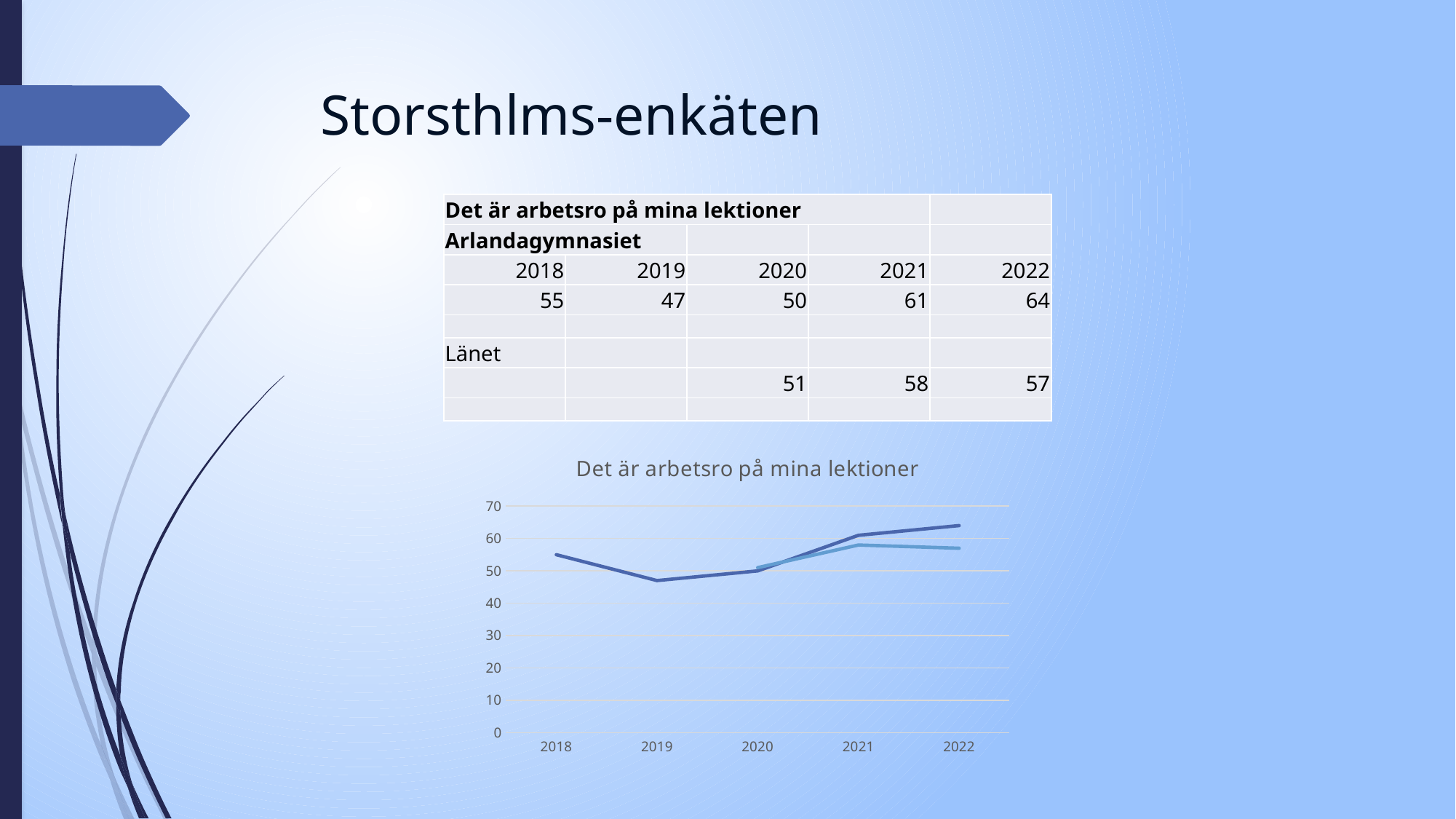
How many lines are plotted in the chart? 2 What is the value for Arlandagymnasiet in 2019? 47 Is the value for Arlandagymnasiet in 2018 greater or less than 50? greater In which year is the Arlandagymnasiet value lowest? 2019 What kind of chart is shown on the slide? line chart What is the value for Länet in 2021? 58 How many years are shown on the x axis of the chart? 5 What is the value for Arlandagymnasiet in 2022? 64 What is the difference between the Arlandagymnasiet value and the Länet value in 2022? 7 In which year is the Arlandagymnasiet value highest? 2022 Does the Arlandagymnasiet line rise or fall from 2019 to 2022? rise What is the title of the chart? Det är arbetsro på mina lektioner